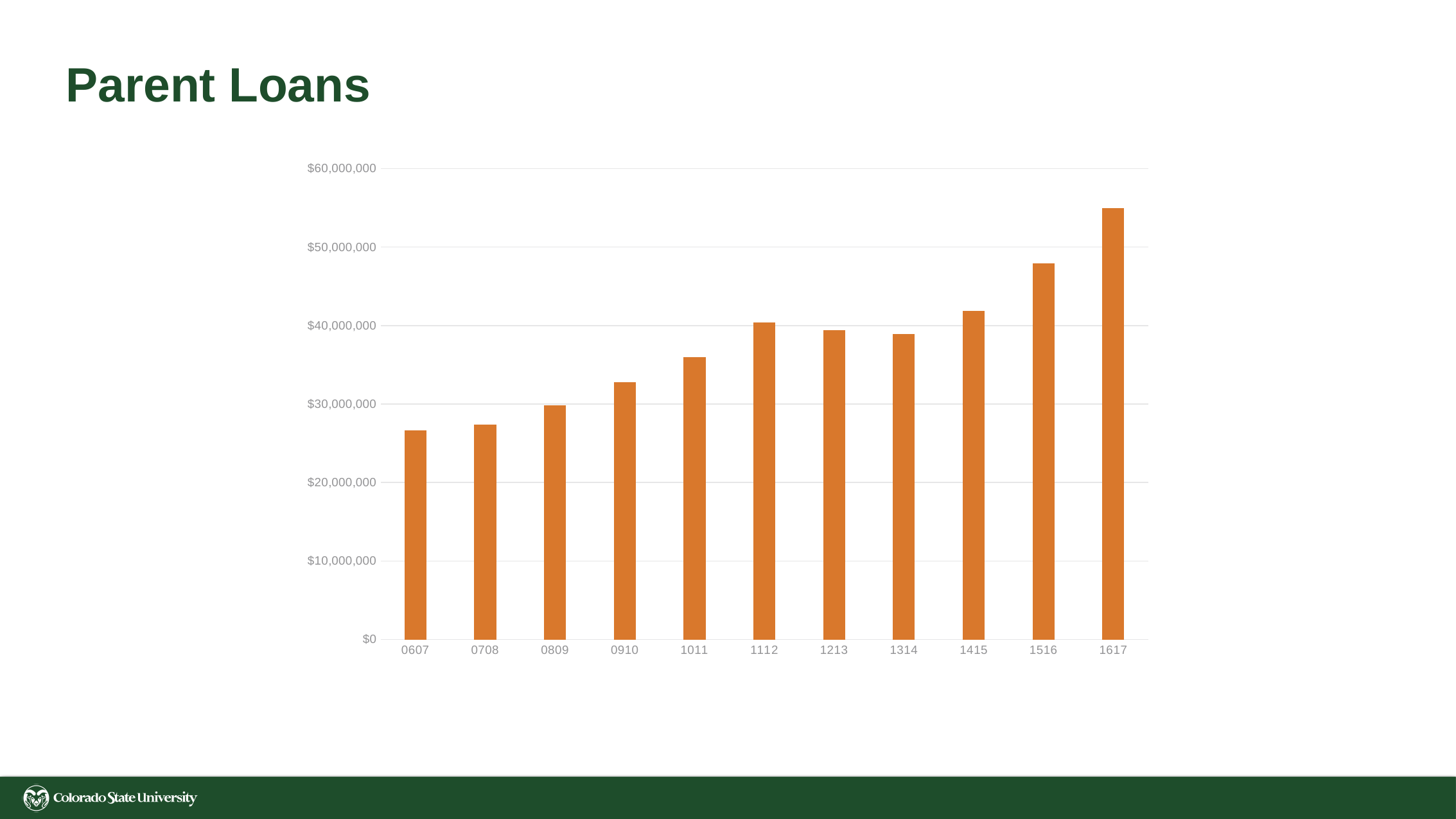
Is the value for 1516 greater or less than $50,000,000? less Is the value for 1617 greater or less than $50,000,000? greater Overall, do the parent loan amounts rise or fall from 0607 to 1617? rise Is the value for 0607 greater or less than $30,000,000? less What kind of chart is shown on the slide? bar chart How many academic years (bars) are shown on the x axis? 11 Which year has the highest parent loan amount? 1617 What is the title of the slide containing the chart? Parent Loans Which is larger, the value for 1516 or the value for 1415? 1516 Which is larger, the value for 1011 or the value for 0910? 1011